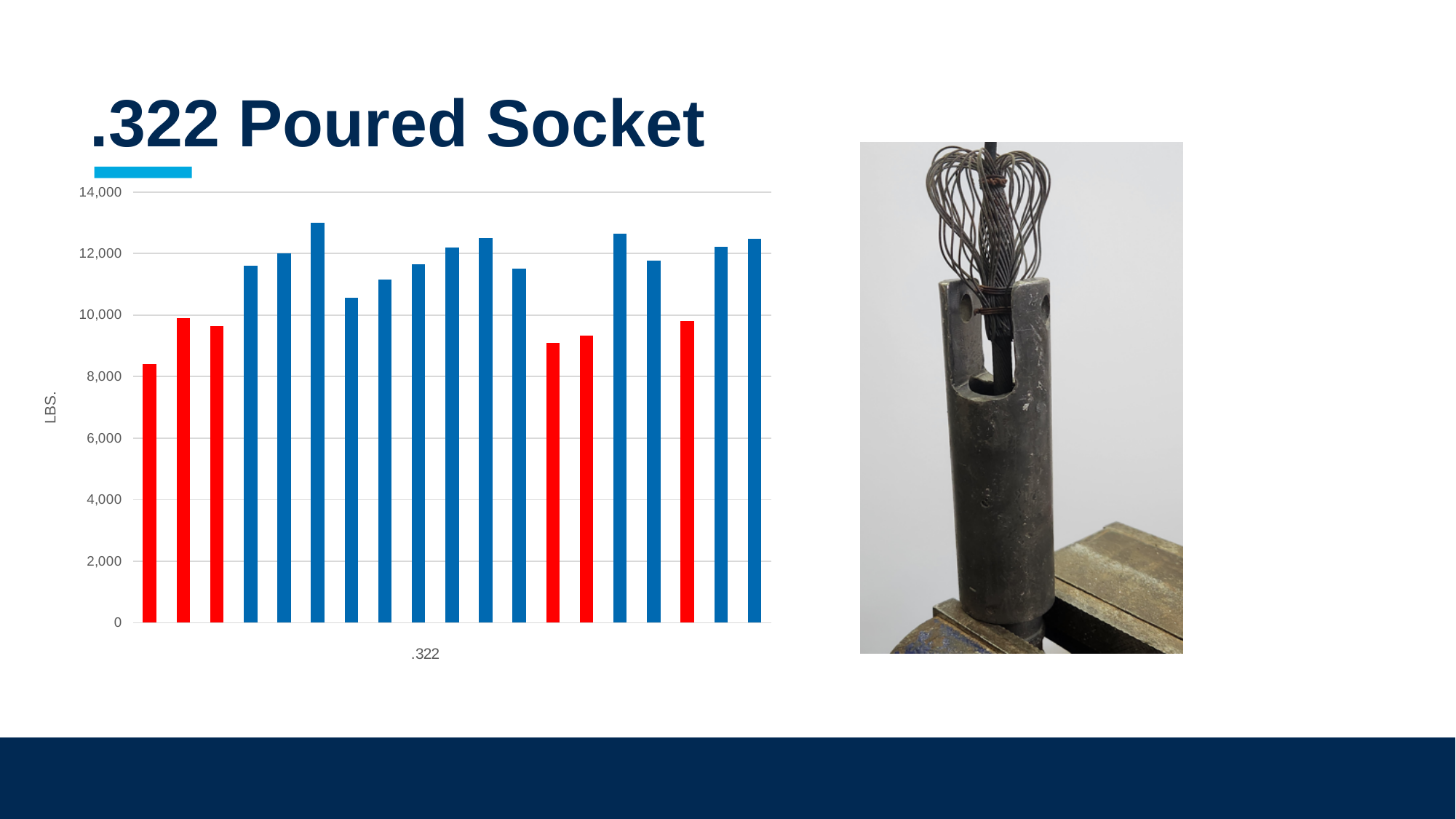
Is the value of the tallest bar greater or less than 12,000? greater What is the label on the vertical axis of the chart? LBS. How many red bars are there in the chart? 6 Which is larger, the first bar or the second bar from the left? the second bar Are all the red bars above or below the 10,000 gridline? below Which bar is the shortest, counting from the left? the 1st (leftmost) bar Which bar is the tallest, counting from the left? the 6th bar What kind of chart is shown on the slide? bar chart How many bars are plotted in the chart? 19 What is the label shown beneath the horizontal axis of the chart? .322 Is the value of the leftmost bar greater or less than 10,000? less How many blue bars are there in the chart? 13